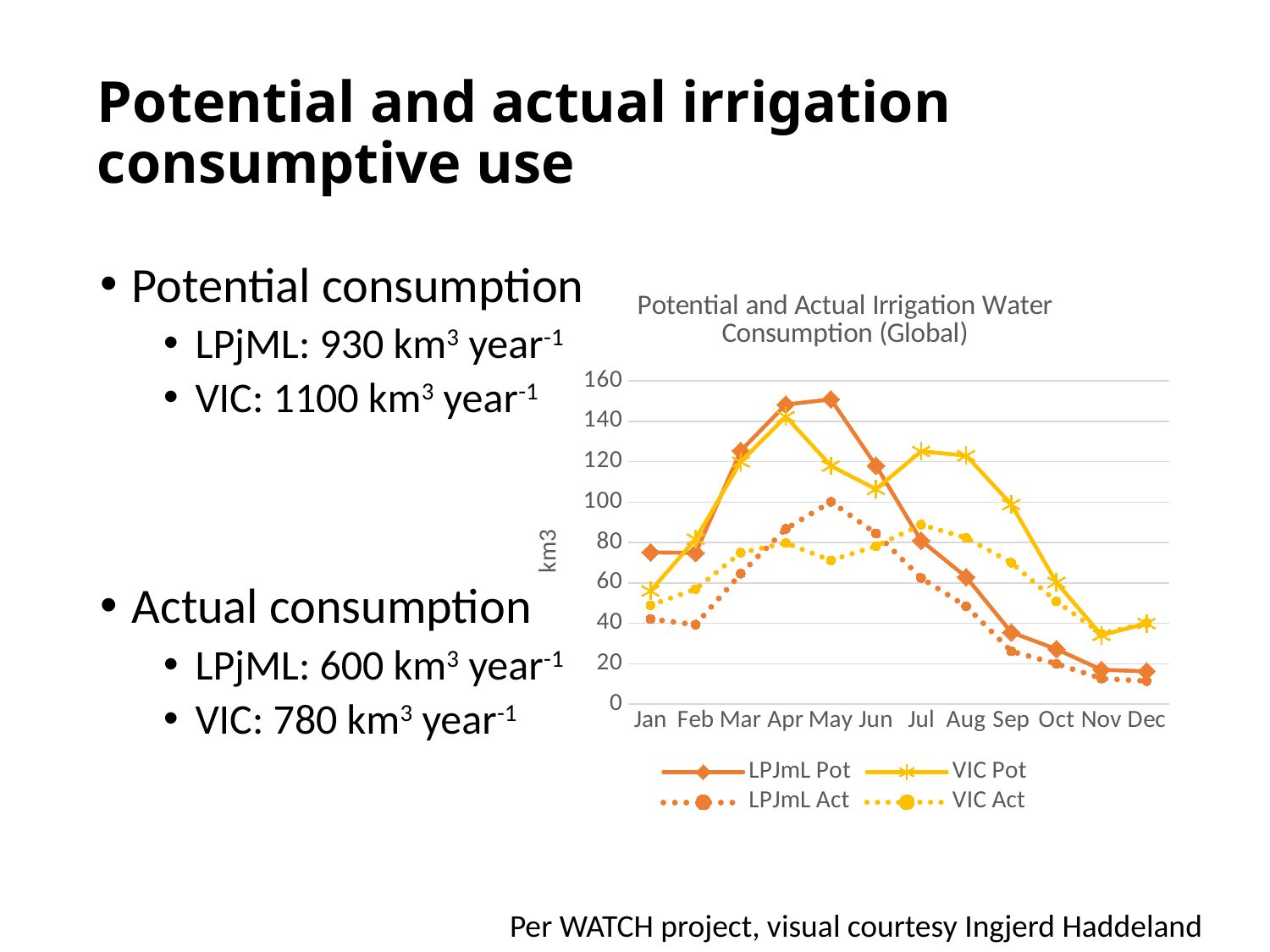
Does the LPJmL Pot series rise or fall from May to Dec? fall In which month does the LPJmL Act series reach its highest value? May In which month does the VIC Pot series reach its highest value? Apr What is the label on the vertical axis of the chart? km3 In which month does the LPJmL Pot series reach its highest value? May How many months are plotted along the x axis of the chart? 12 How many series does the chart legend list? 4 In Jul, which series has the larger value: LPJmL Pot or VIC Pot? VIC Pot Is the value for LPJmL Act in Jan greater or less than 60? less Is the value for LPJmL Pot in May greater or less than 140? greater Is the value for VIC Pot in Jul greater or less than 100? greater What kind of chart is shown on the slide? line chart